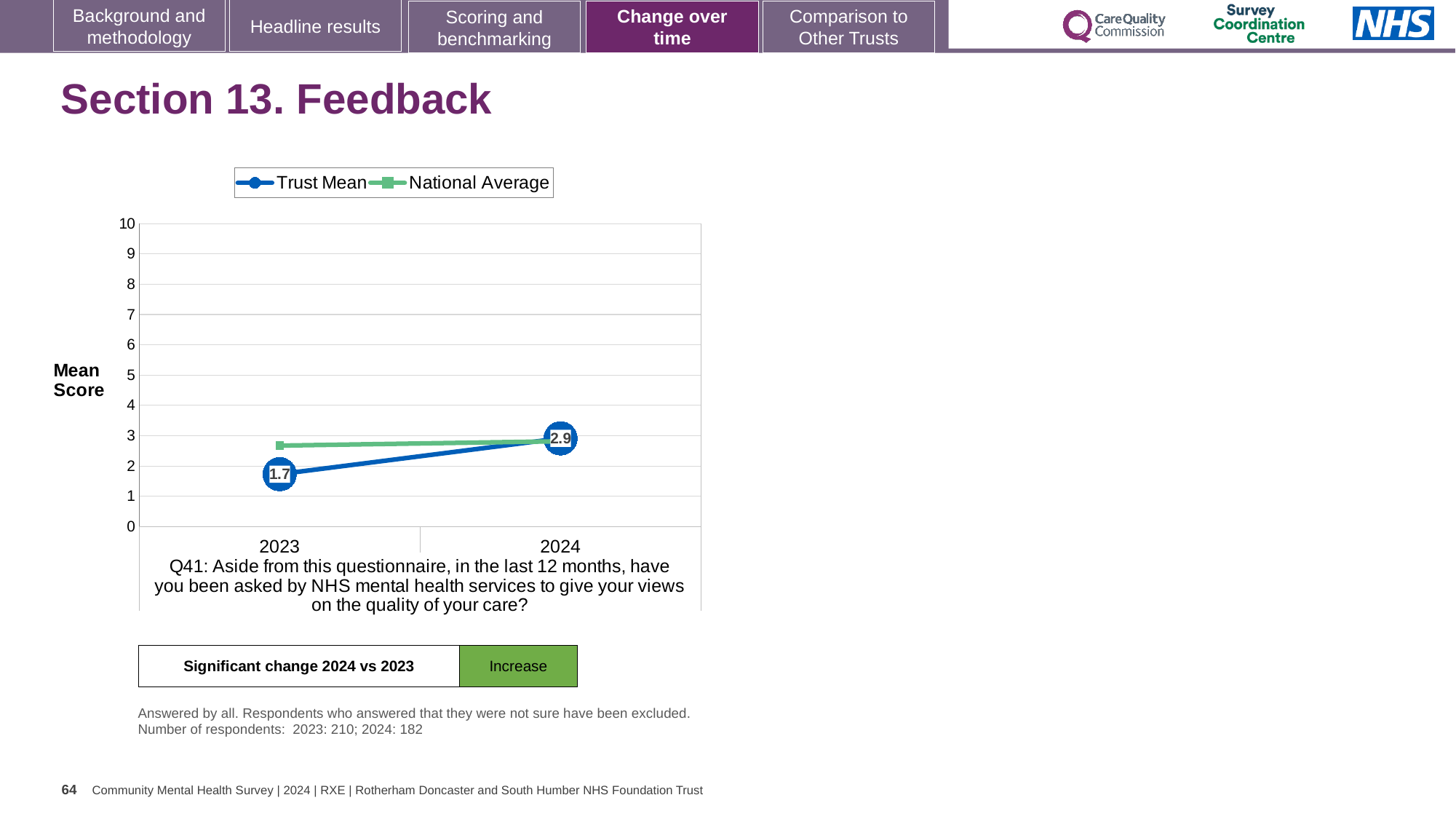
In which year is the Trust Mean higher? 2024 In which year is the Trust Mean lower? 2023 How many years are shown on the x axis? 2 By how much did the Trust Mean change from 2023 to 2024? 1.2 What kind of chart is shown on the slide? line chart How many series does the legend list? 2 Is the National Average value for 2023 greater or less than 3? less In 2023, which is larger: the Trust Mean or the National Average? National Average Does the Trust Mean rise or fall from 2023 to 2024? rise What is the Trust Mean value for 2024? 2.9 Is the National Average value for 2023 greater or less than 2? greater What is the Trust Mean value for 2023? 1.7